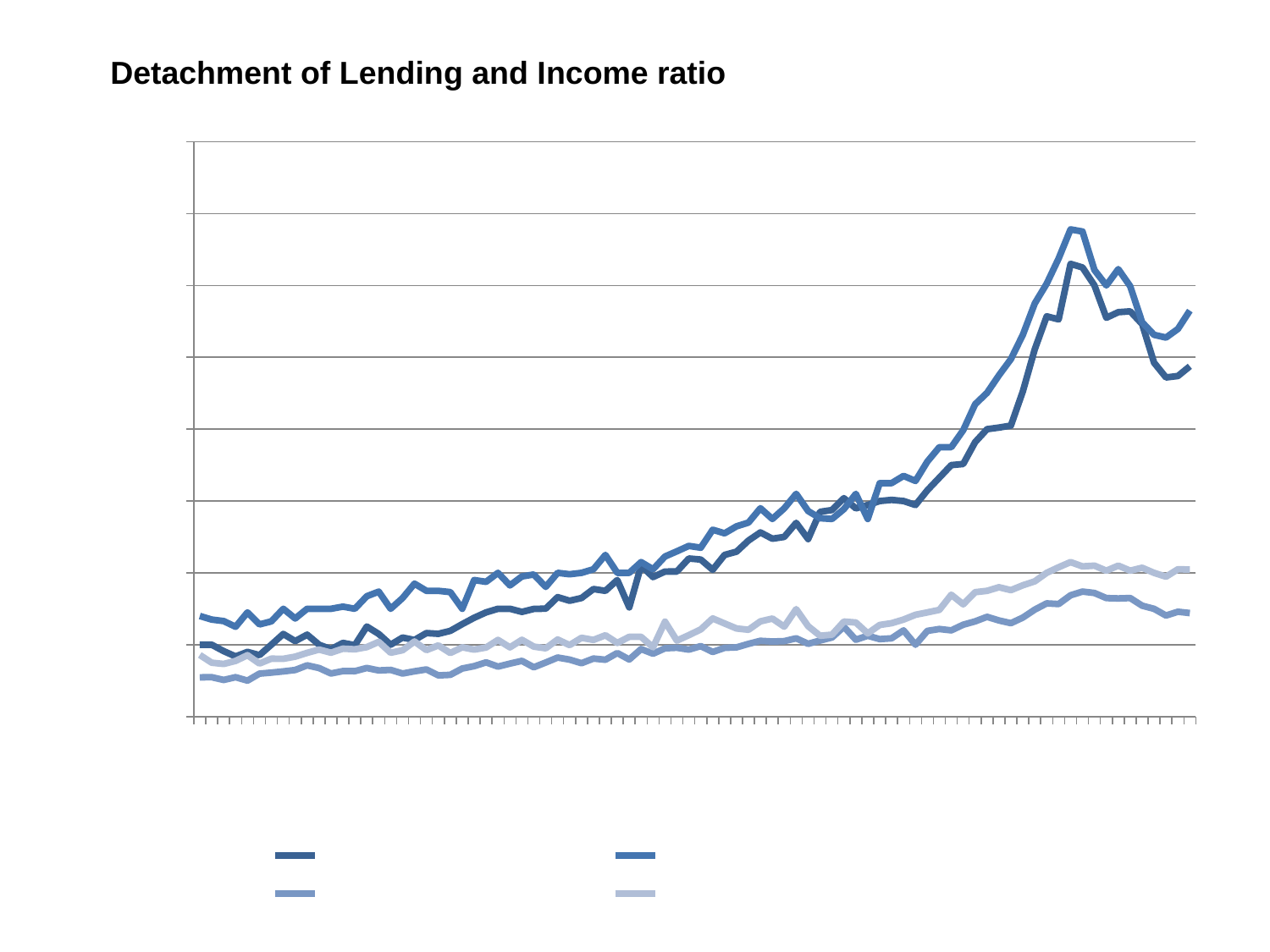
Do the two upper lines rise or fall immediately after reaching their peak near the right side of the chart? fall What is the title of the chart on the slide? Detachment of Lending and Income ratio What kind of chart is shown on the slide? line chart What colour family are the lines in the chart drawn in? blue Do the plotted lines generally rise or fall from left to right across the chart? rise How many lines are plotted on the chart? 4 How many series does the legend list? 4